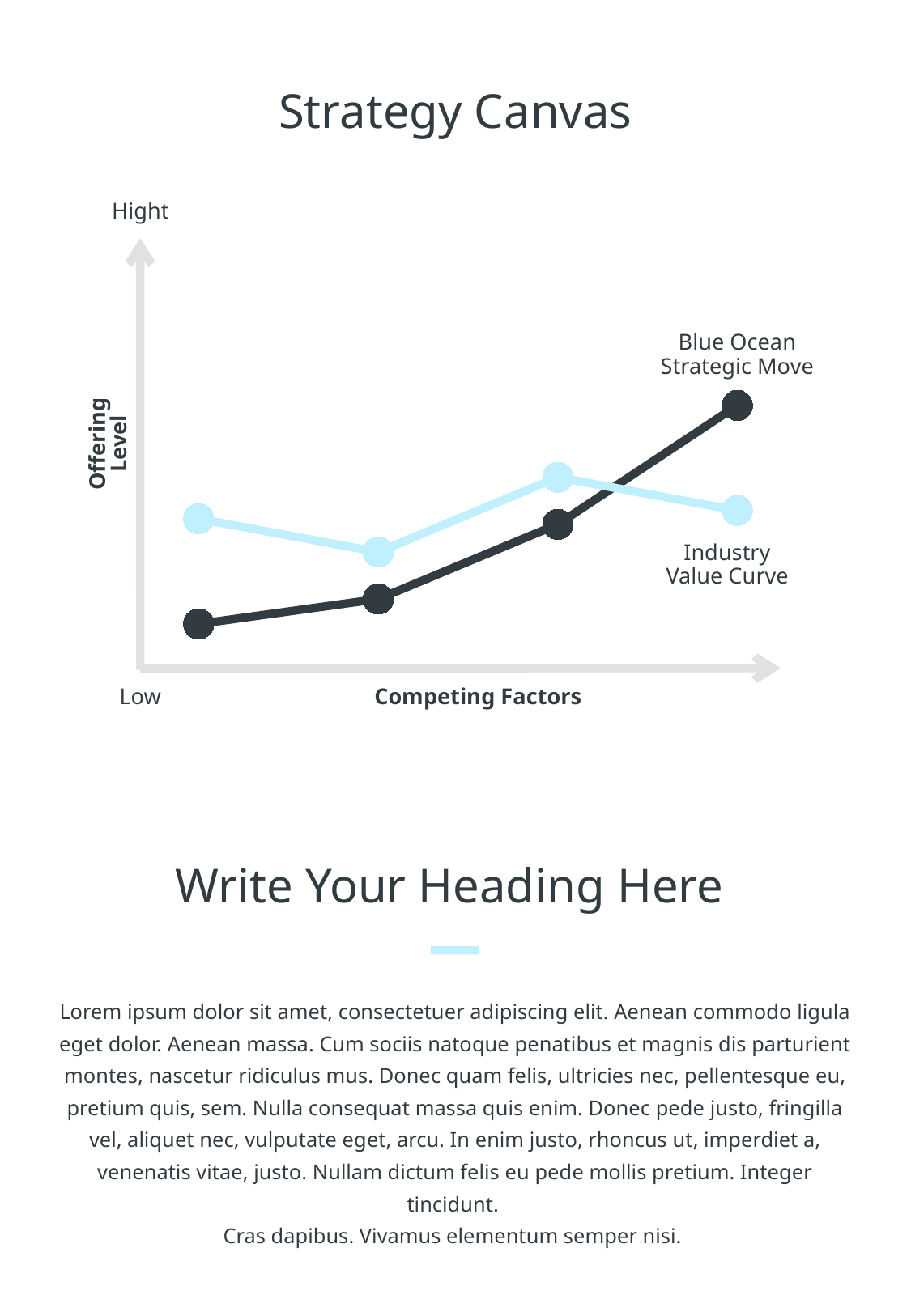
How many data points does the Blue Ocean Strategic Move line have? 4 Which line contains the lowest point on the chart? Blue Ocean Strategic Move Does the Blue Ocean Strategic Move line rise or fall from left to right? Rise What kind of chart is shown on the slide? Line chart At the leftmost competing factor, which line is higher: Blue Ocean Strategic Move or Industry Value Curve? Industry Value Curve How many lines (series) are plotted on the chart? 2 At the rightmost competing factor, which line is higher: Blue Ocean Strategic Move or Industry Value Curve? Blue Ocean Strategic Move What is the title of the chart? Strategy Canvas What is the label on the horizontal axis of the chart? Competing Factors How many data points does the Industry Value Curve line have? 4 At the third competing factor from the left, which line is higher: Blue Ocean Strategic Move or Industry Value Curve? Industry Value Curve Which line reaches the highest offering level on the chart? Blue Ocean Strategic Move